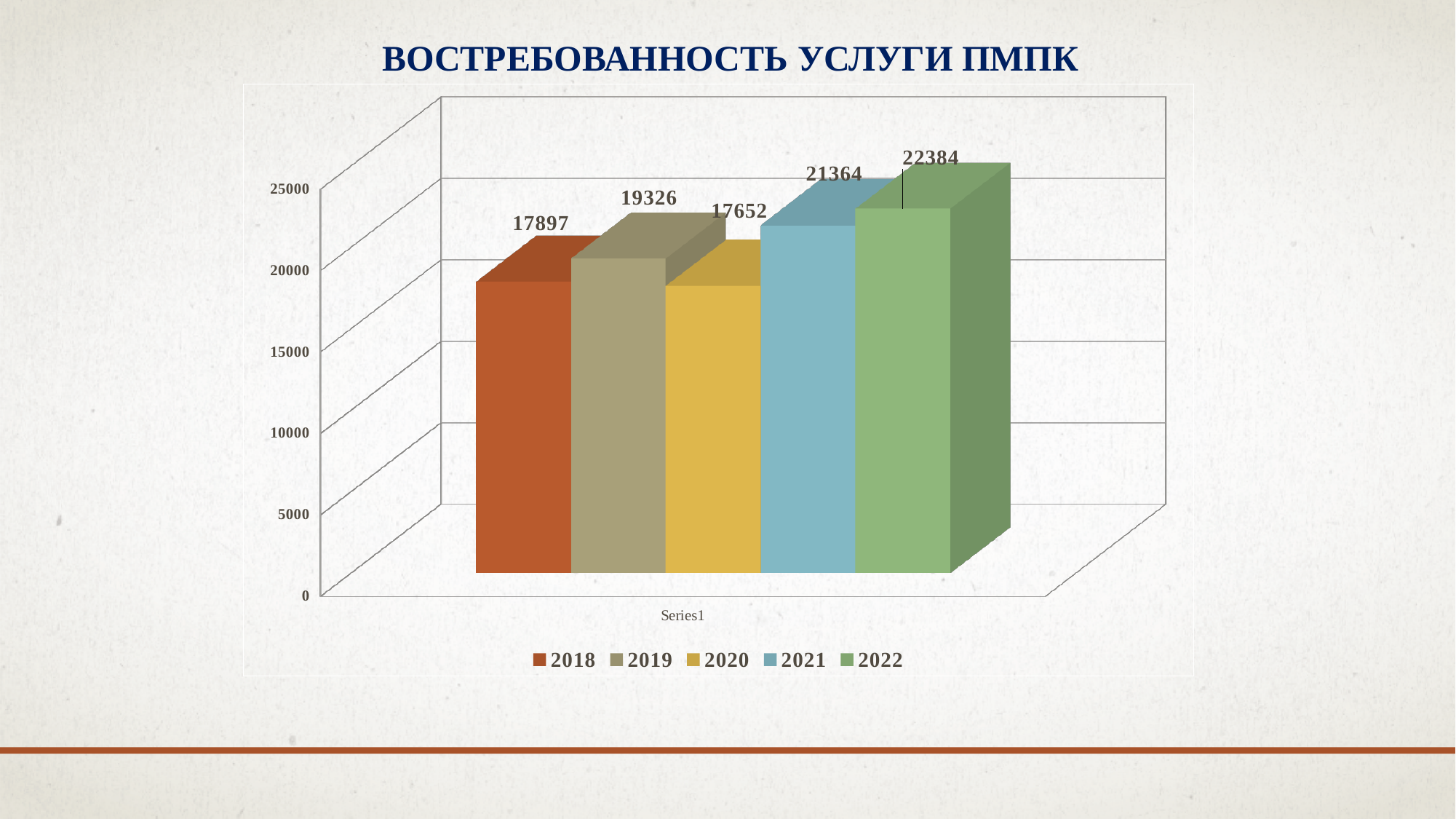
Which is larger, the value for 2019 or the value for 2020? 2019 What is the value for 2022? 22384 What kind of chart is shown on the slide? bar chart What is the title of the chart? ВОСТРЕБОВАННОСТЬ УСЛУГИ ПМПК How many series does the legend list? 5 Is the value for 2021 greater or less than 20000? greater Which year has the lowest value? 2020 Which year has the highest value? 2022 What is the value for 2020? 17652 What is the difference between the values for 2022 and 2021? 1020 What is the difference between the values for 2019 and 2018? 1429 What is the value for 2018? 17897